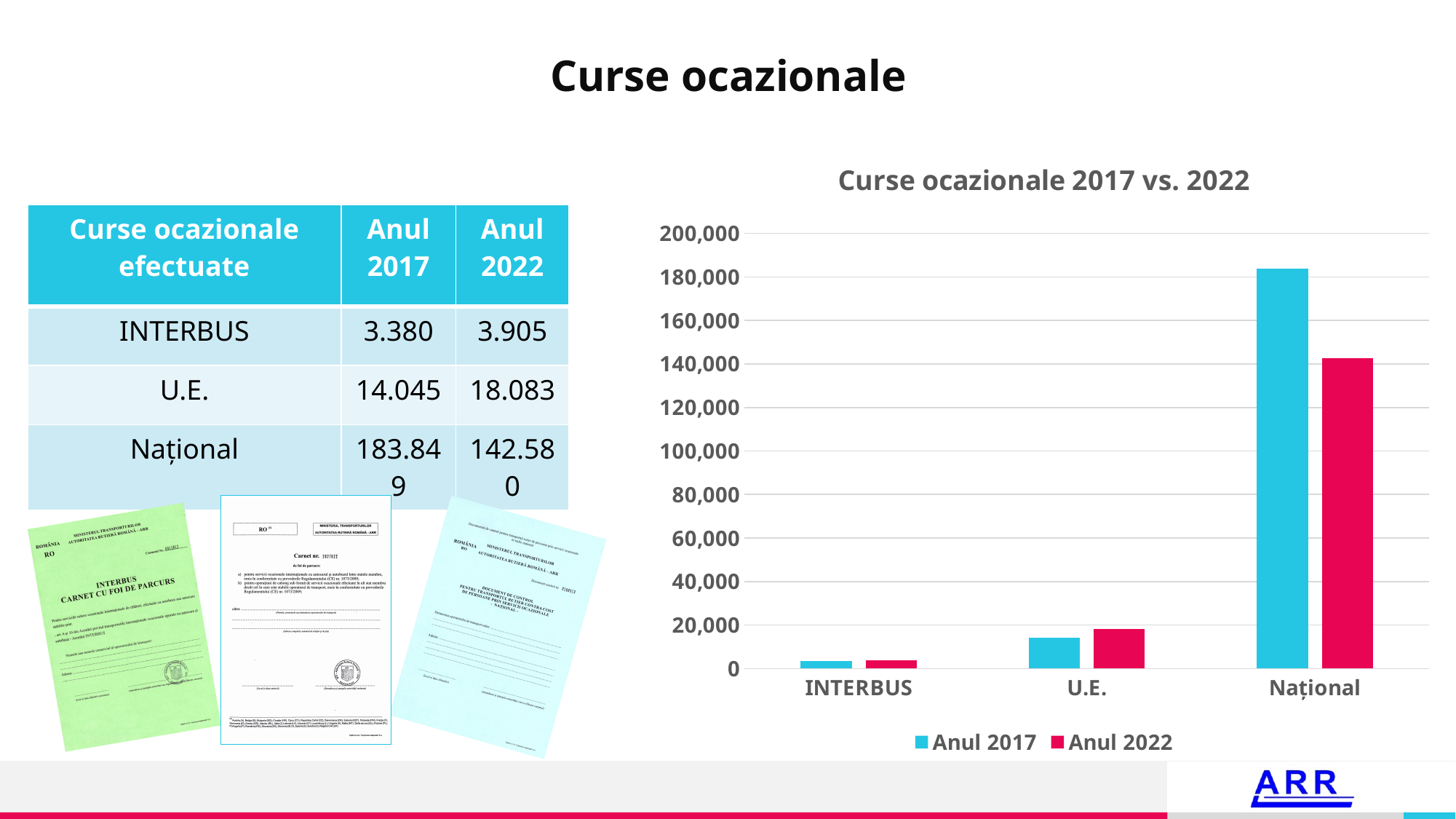
For Național, which is larger: the Anul 2017 bar or the Anul 2022 bar? Anul 2017 Which category has the lowest bar for Anul 2022? INTERBUS What is the title of the chart? Curse ocazionale 2017 vs. 2022 Is the Anul 2022 value for Național greater or less than 160,000? less How many categories are shown on the x axis of the chart? 3 What kind of chart is shown on the slide? bar chart How many series does the chart legend list? 2 Is the Anul 2022 value for U.E. greater or less than 20,000? less Is the Anul 2017 value for Național greater or less than 180,000? greater According to the table on the slide, what is the Anul 2022 value for U.E.? 18.083 Which category has the highest bar for Anul 2017? Național For U.E., which is larger: the Anul 2017 bar or the Anul 2022 bar? Anul 2022